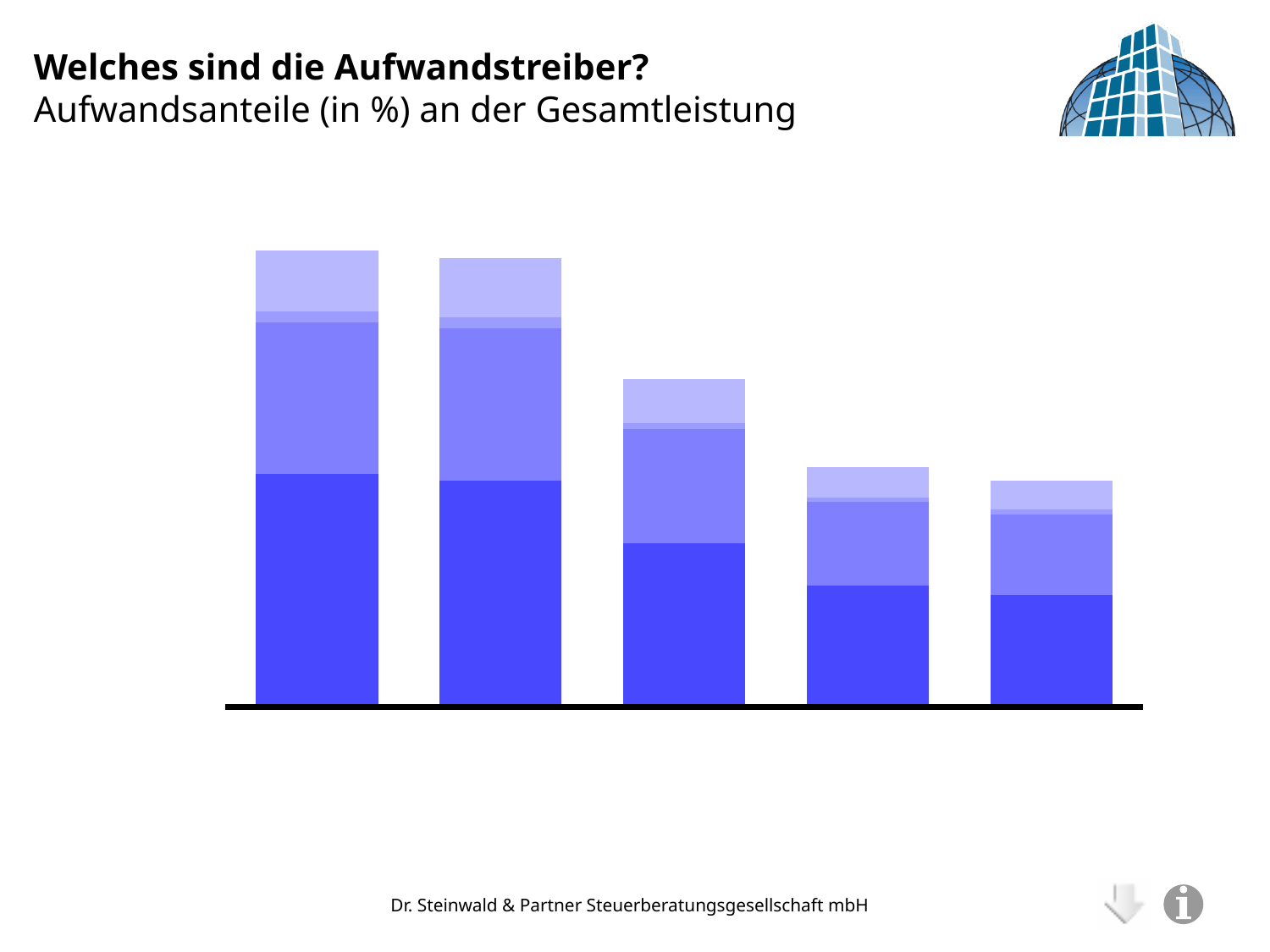
Do the bar heights rise or fall from left to right? fall What kind of chart is shown on the slide? stacked bar chart How many stacked segments does each bar have? 4 How many bars does the chart contain? 5 Which segment is the largest in every bar: the bottom, second, third or top segment? the bottom segment Which bar is the tallest, by position? the leftmost bar What is the subtitle of the chart slide? Aufwandsanteile (in %) an der Gesamtleistung Is the leftmost bar or the rightmost bar taller? the leftmost bar Which bar is the shortest, by position? the rightmost bar Is the middle bar taller or shorter than the second bar from the left? shorter